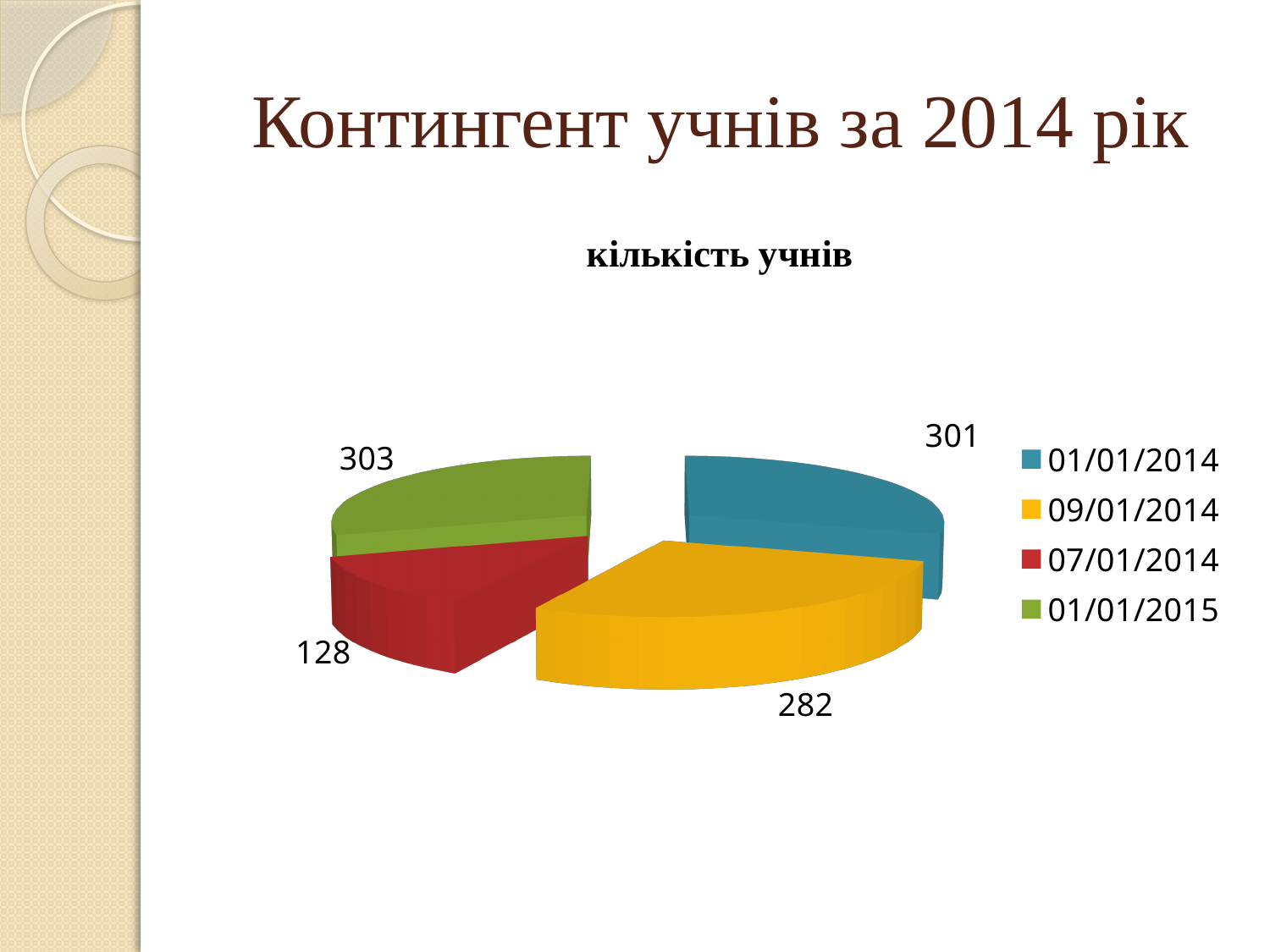
What is the value for 07/01/2014 in the pie chart? 128 Which date has the largest value in the pie chart? 01/01/2015 Which is larger, the value for 01/01/2014 or the value for 09/01/2014? 01/01/2014 What is the difference between the values for 01/01/2015 and 07/01/2014? 175 What is the value for 01/01/2014 in the pie chart? 301 What is the title of the chart? кількість учнів Which date has the smallest value in the pie chart? 07/01/2014 What is the value for 01/01/2015 in the pie chart? 303 What is the difference between the values for 01/01/2014 and 09/01/2014? 19 What is the value for 09/01/2014 in the pie chart? 282 How many slices does the pie chart have? 4 What kind of chart is shown on the slide? pie chart